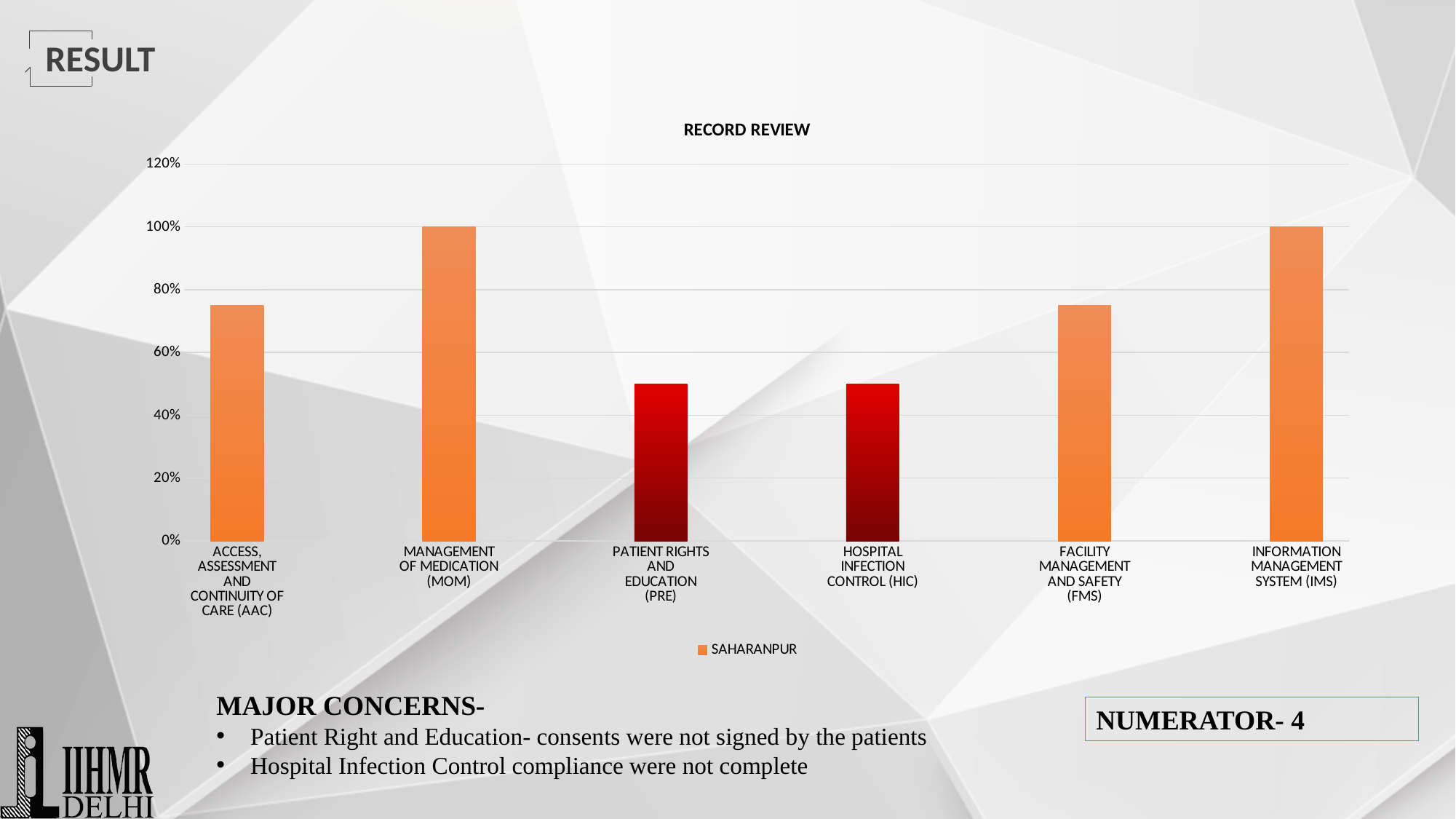
What is the value for MANAGEMENT OF MEDICATION (MOM)? 100% What type of chart is shown on the slide? bar chart What is the value for INFORMATION MANAGEMENT SYSTEM (IMS)? 100% Is the value for ACCESS, ASSESSMENT AND CONTINUITY OF CARE (AAC) greater or less than 80%? less How many series does the chart legend list? 1 What series name is shown in the chart legend? SAHARANPUR Is the value for PATIENT RIGHTS AND EDUCATION (PRE) greater or less than 60%? less What is the title of the chart? RECORD REVIEW Is the value for FACILITY MANAGEMENT AND SAFETY (FMS) greater or less than 60%? greater How many categories are plotted on the x axis of the chart? 6 Which has the larger value, MANAGEMENT OF MEDICATION (MOM) or PATIENT RIGHTS AND EDUCATION (PRE)? MANAGEMENT OF MEDICATION (MOM)